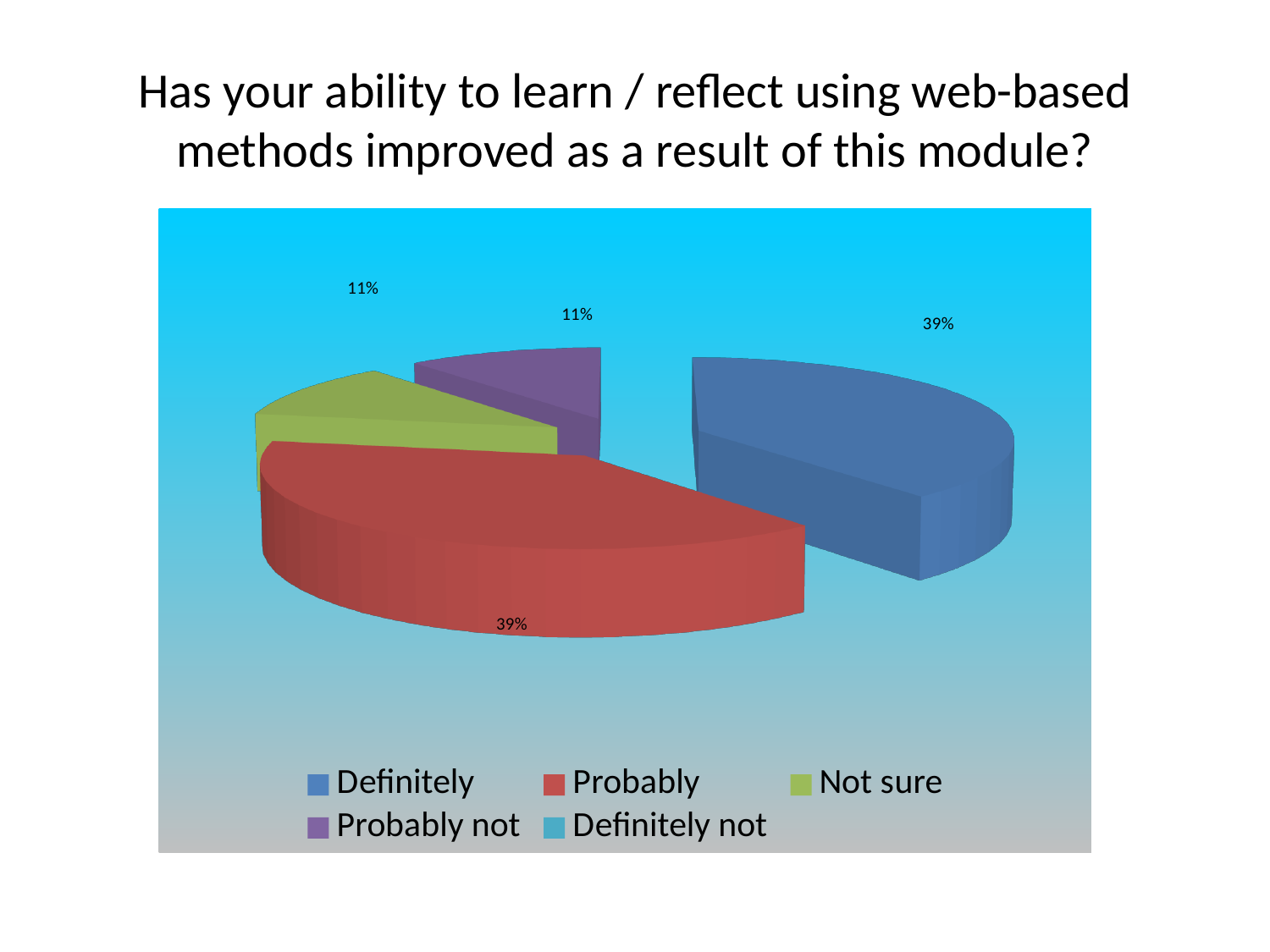
How many categories does the legend list? 5 Which is larger, the share for "Definitely" or the share for "Not sure"? Definitely What colour is the "Probably" slice in the pie chart? Red What is the title of the slide above the chart? Has your ability to learn / reflect using web-based methods improved as a result of this module? What is the combined share of "Definitely" and "Probably"? 78% What percentage of respondents answered "Probably not"? 11% What percentage of respondents answered "Definitely"? 39% What kind of chart is shown on the slide? Pie chart How many slices with data labels are visible in the pie chart? 4 What percentage of respondents answered "Probably"? 39% What percentage of respondents answered "Not sure"? 11% What is the difference in percentage points between the "Probably" share and the "Probably not" share? 28